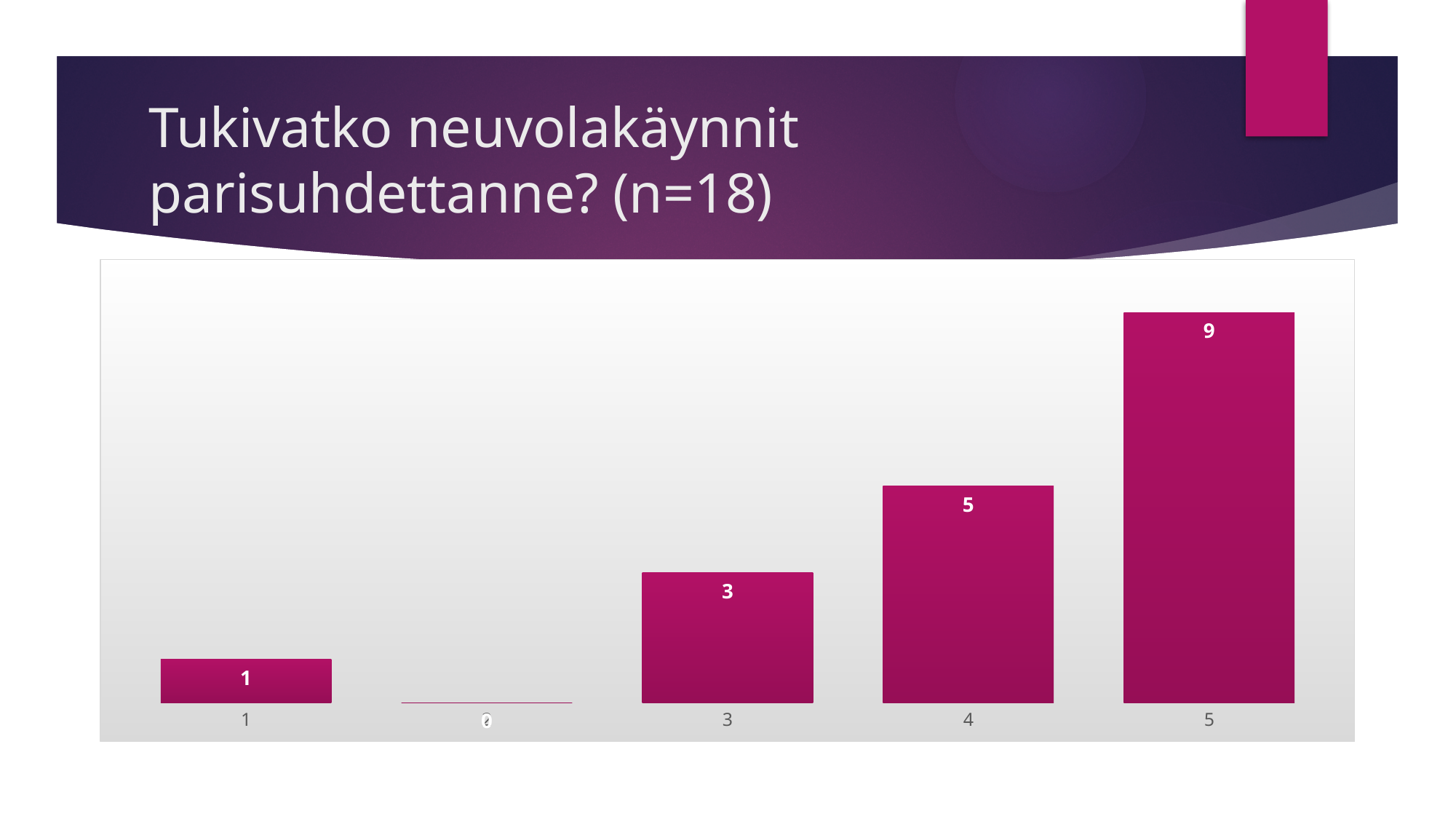
What is the difference between the values for category 5 and category 4? 4 What is the difference between the values for category 4 and category 3? 2 What is the value for category 1? 1 Which has a larger value, category 3 or category 4? 4 What is the value for category 5? 9 What is the difference between the values for category 5 and category 1? 8 Do the values rise or fall from category 3 to category 5? rise What is the value for category 4? 5 Which category has the highest value? 5 What is the value for category 3? 3 How many categories are shown on the x axis? 5 What kind of chart is shown on the slide? bar chart